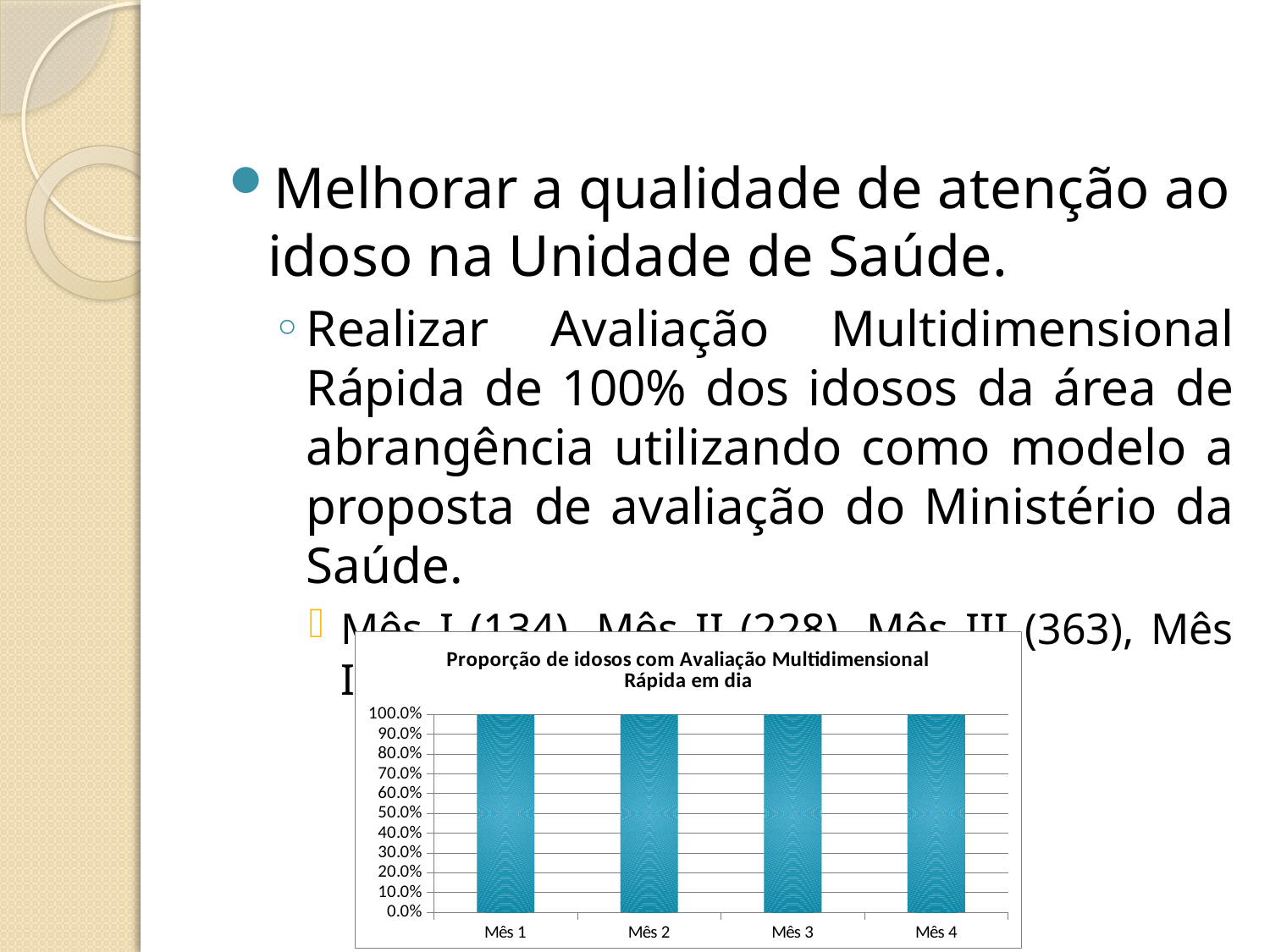
What is the value for Mês 4 on the chart? 100.0% What is the label of the first category on the x axis? Mês 1 Do the values rise, fall, or stay the same from Mês 1 to Mês 4? stay the same What kind of chart is shown on the slide? bar chart What is the title of the chart? Proporção de idosos com Avaliação Multidimensional Rápida em dia How many categories (months) are plotted on the chart? 4 Is the value for Mês 3 greater or less than 50.0%? greater What is the difference between the values for Mês 1 and Mês 4? 0.0% What is the value for Mês 3 on the chart? 100.0% What is the value for Mês 1 on the chart? 100.0% What is the value for Mês 2 on the chart? 100.0% Is the value for Mês 1 greater or less than 90.0%? greater